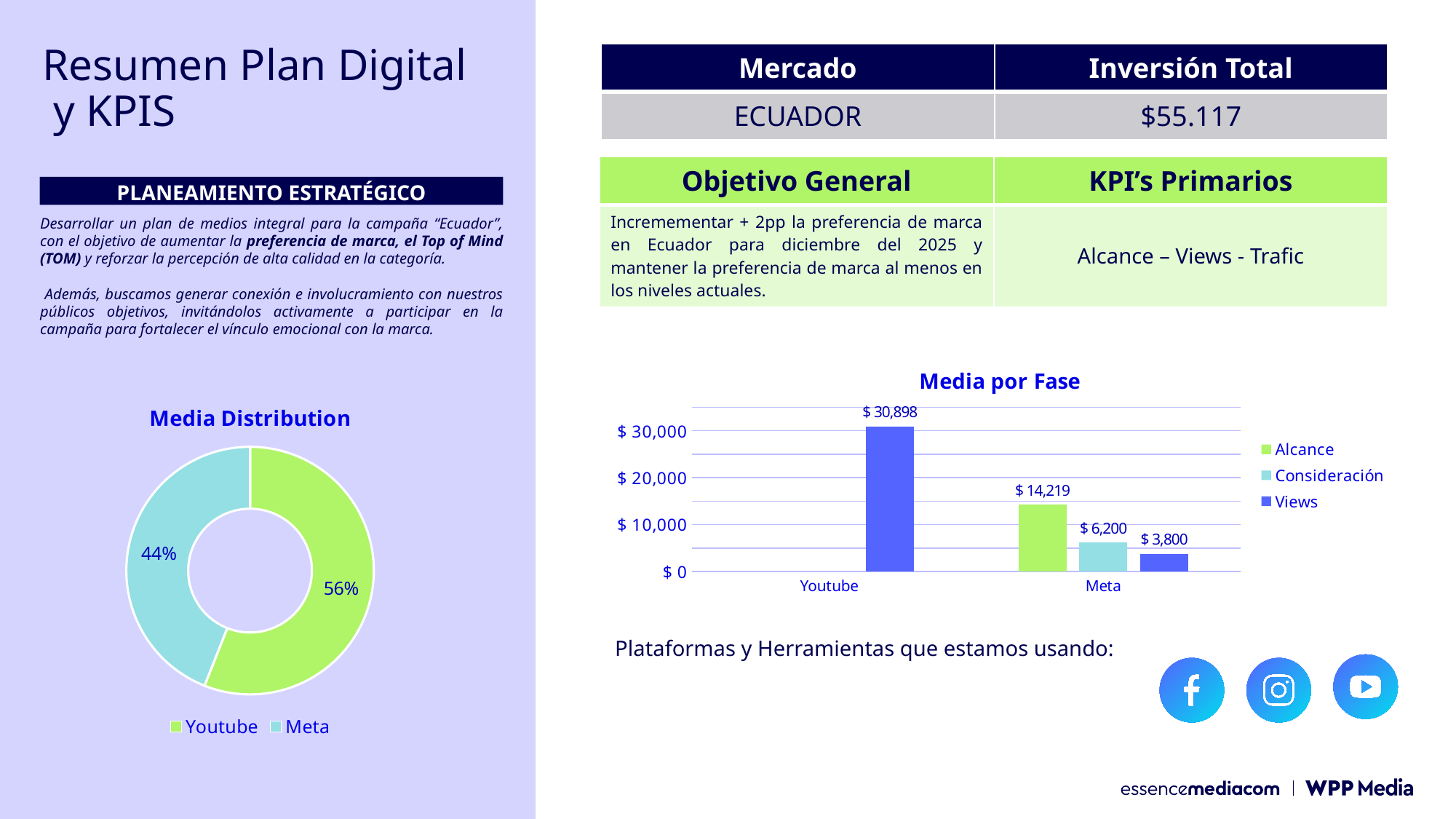
In the 'Media por Fase' chart, what is the Views value for Youtube? $ 30,898 In the 'Media por Fase' chart, how many series does the legend list? 3 In the 'Media por Fase' chart, what is the Consideración value for Meta? $ 6,200 In the 'Media Distribution' chart, which platform has the larger share? Youtube In the 'Media por Fase' chart, what is the difference between the Views value for Youtube and the Views value for Meta? $ 27,098 What kind of chart is 'Media por Fase'? Bar chart What kind of chart is 'Media Distribution'? Doughnut chart In the 'Media Distribution' chart, what share does Meta have? 44% In the 'Media por Fase' chart, is the Alcance value for Meta greater or less than 10,000? greater In the 'Media por Fase' chart, what is the Views value for Meta? $ 3,800 In the 'Media por Fase' chart, what is the Alcance value for Meta? $ 14,219 In the 'Media Distribution' chart, what share does Youtube have? 56%